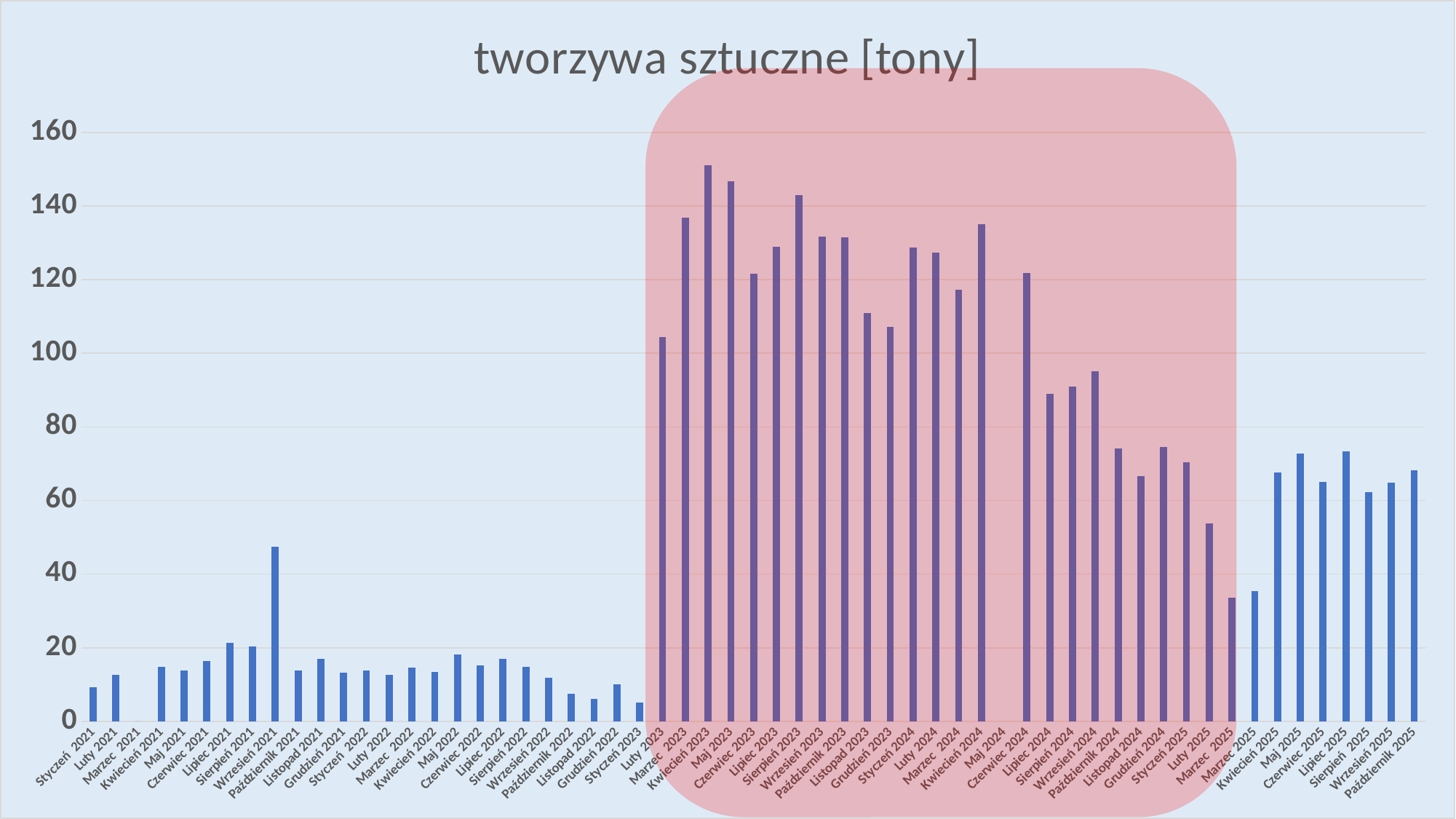
Is the value for Luty 2023 greater or less than 100? greater Is the value for Maj 2025 greater or less than 60? greater Which is larger, the value for Kwiecień 2023 or the value for Wrzesień 2021? Kwiecień 2023 What type of chart is shown on the slide? bar chart Which is larger, the value for Grudzień 2022 or the value for Październik 2025? Październik 2025 Do the values generally rise or fall from Czerwiec 2024 to Marzec 2025? fall Is the value for Grudzień 2022 greater or less than 20? less What is the title of the chart? tworzywa sztuczne [tony] How many monthly categories are plotted along the x axis? 59